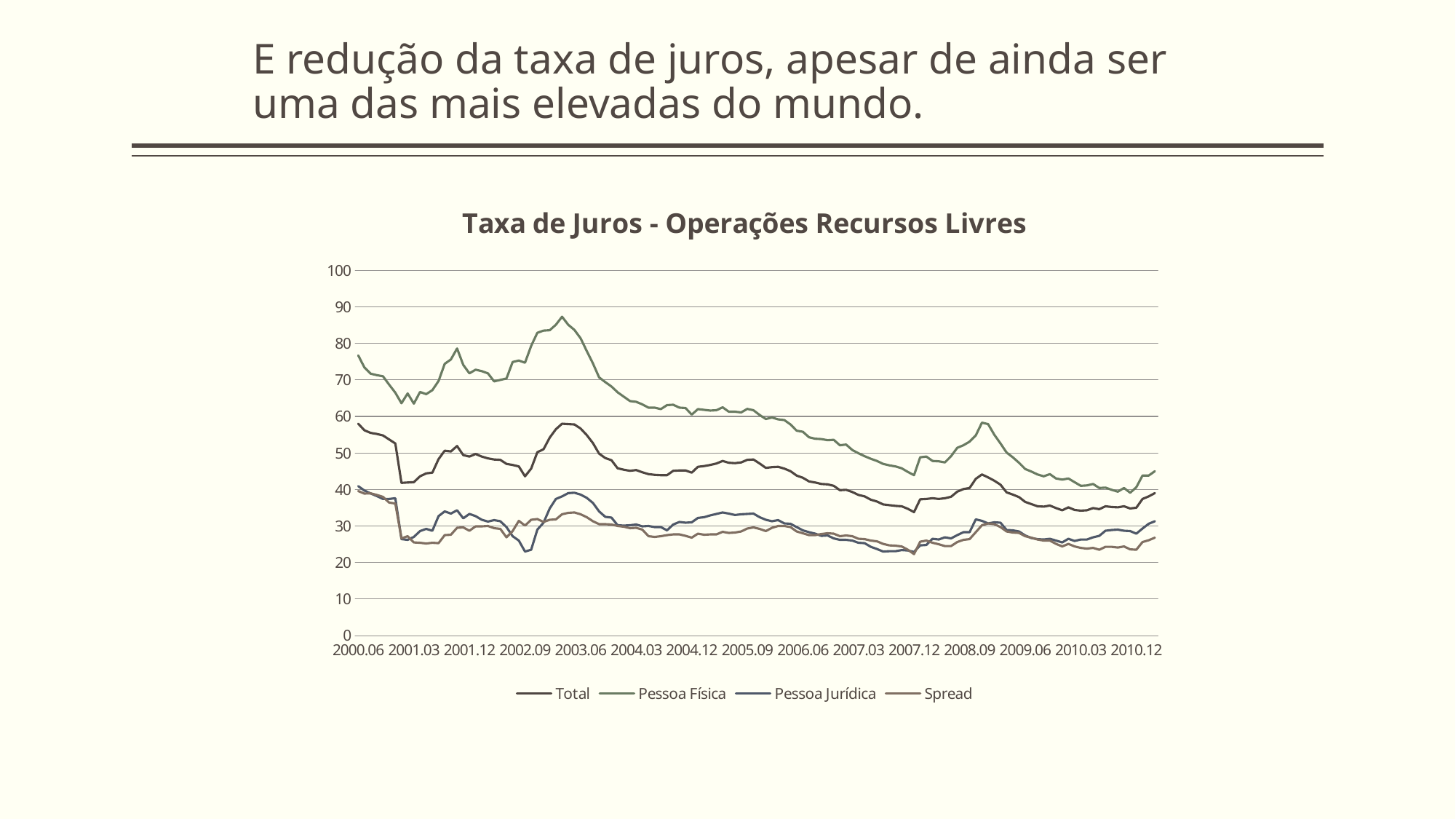
What kind of chart is shown on the slide? line chart Is the value of Pessoa Jurídica at 2002.09 greater or less than 30? less What is the title of the chart? Taxa de Juros - Operações Recursos Livres Is the value of Pessoa Física at 2010.12 greater or less than 50? less At 2003.06, which is larger: Pessoa Física or Total? Pessoa Física How many series does the legend list? 4 Is the value of Total at 2000.06 greater or less than 50? greater Which series is plotted highest across the whole chart? Pessoa Física How many labels are shown on the x axis? 15 Does the Pessoa Física series overall rise or fall from 2000.06 to 2010.12? fall